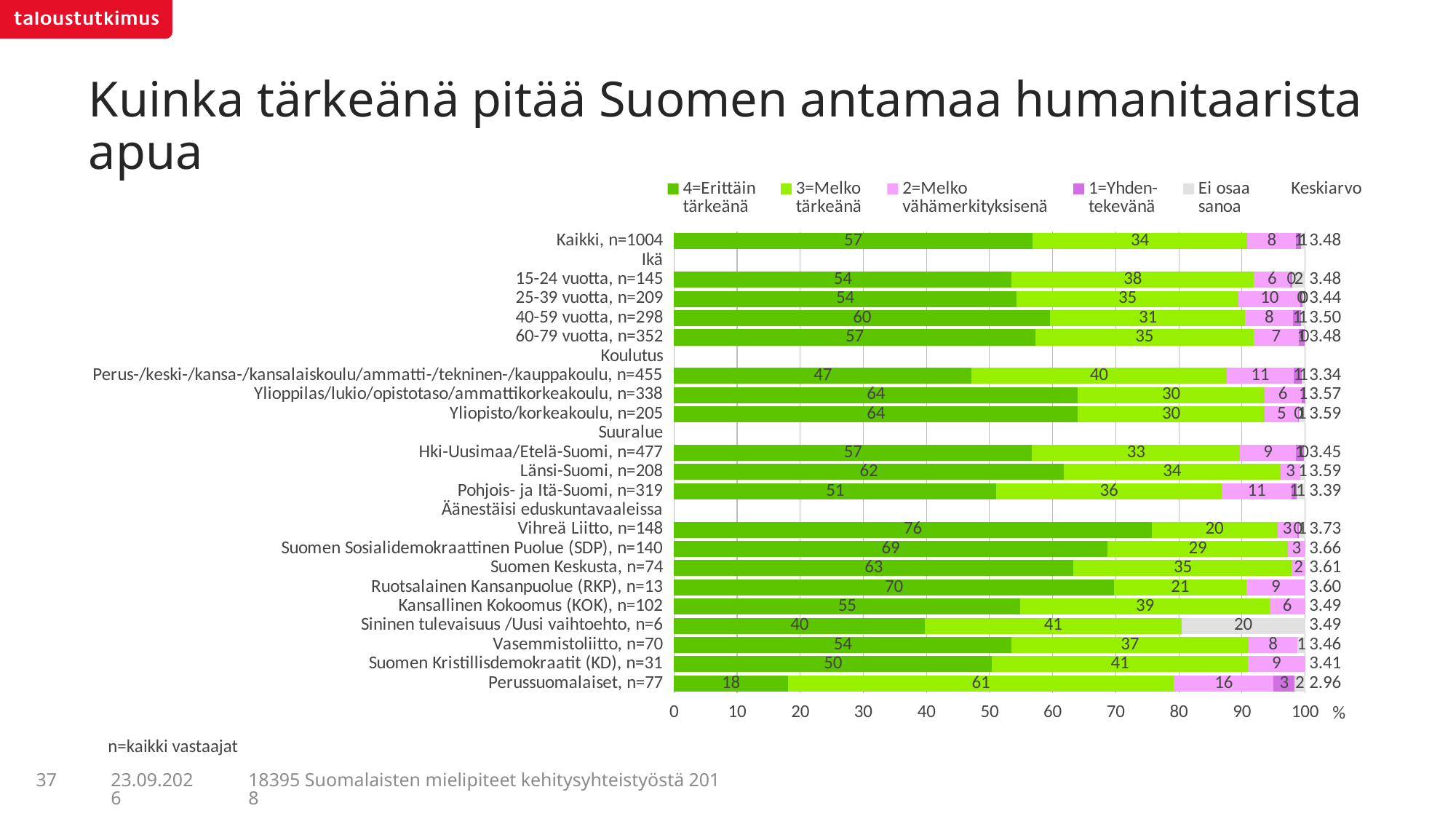
What is the title of the chart on the slide? Kuinka tärkeänä pitää Suomen antamaa humanitaarista apua Which group has the highest share of 4=Erittäin tärkeänä responses? Vihreä Liitto, n=148 Which has a larger 4=Erittäin tärkeänä share: Länsi-Suomi, n=208 or Pohjois- ja Itä-Suomi, n=319? Länsi-Suomi, n=208 What percentage of Perussuomalaiset, n=77 answered 3=Melko tärkeänä? 61 What kind of chart is shown on the slide? Stacked bar chart What is the difference in the 4=Erittäin tärkeänä share between Vihreä Liitto, n=148 and Perussuomalaiset, n=77? 58 What is the Keskiarvo (mean) value shown for Vihreä Liitto, n=148? 3.73 What is the Keskiarvo value for the 40-59 vuotta, n=298 group? 3.50 What percentage of all respondents (Kaikki, n=1004) answered 4=Erittäin tärkeänä? 57 What percentage of the Perus-/keski-/kansa-/kansalaiskoulu/ammatti-/tekninen-/kauppakoulu, n=455 group answered 2=Melko vähämerkityksisenä? 11 Which group has the lowest Keskiarvo value? Perussuomalaiset, n=77 What is the Ei osaa sanoa share for Sininen tulevaisuus /Uusi vaihtoehto, n=6? 20